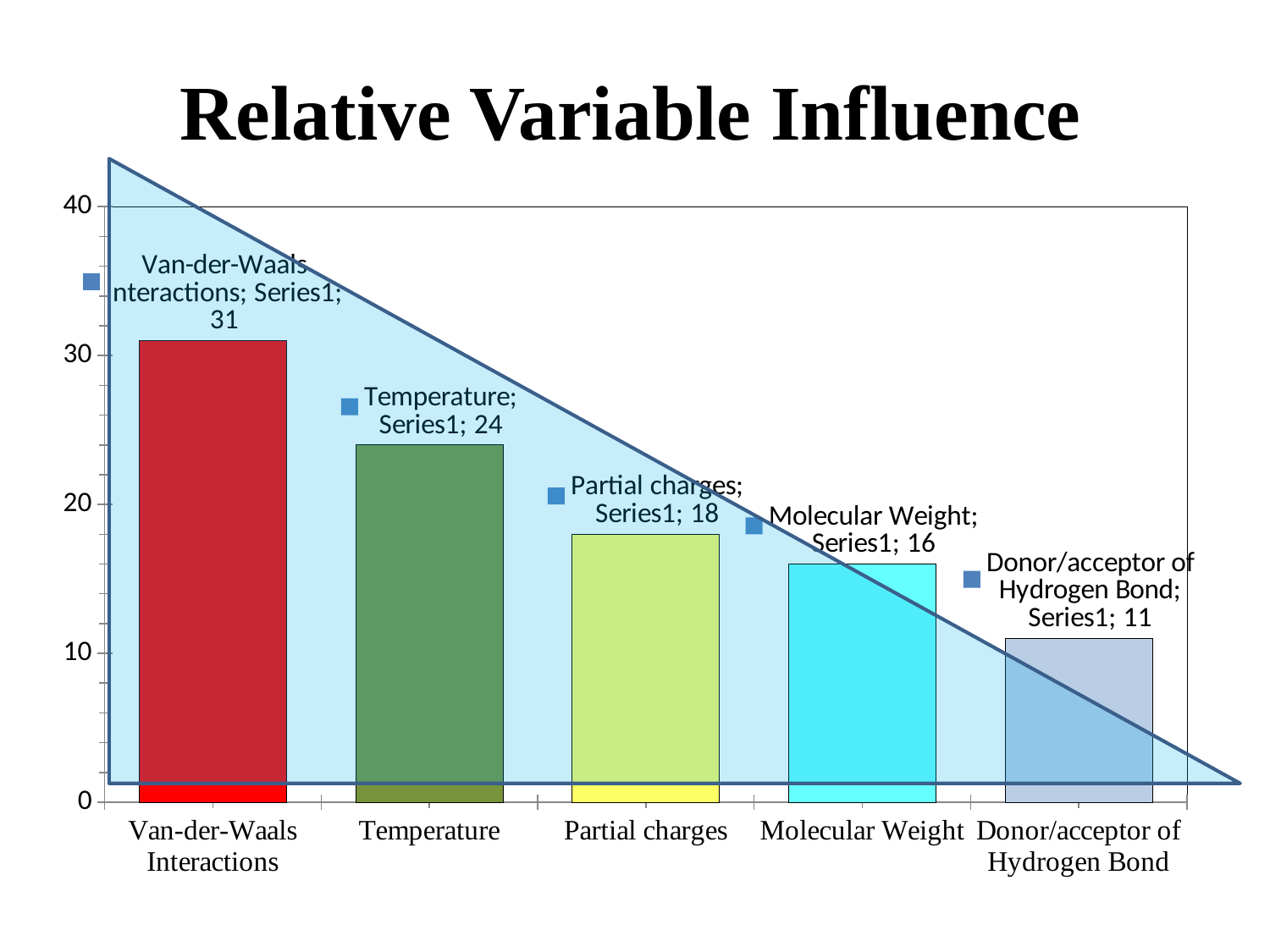
What is the value for Temperature? 24 Which category has the lowest value? Donor/acceptor of Hydrogen Bond What is the value for Donor/acceptor of Hydrogen Bond? 11 What kind of chart is shown on the slide? Bar chart What is the value for Partial charges? 18 Do the values rise or fall from left to right along the x axis? Fall What is the value for Van-der-Waals Interactions? 31 How many categories are shown on the x axis? 5 What is the difference between the values for Van-der-Waals Interactions and Temperature? 7 What is the difference between the values for Molecular Weight and Donor/acceptor of Hydrogen Bond? 5 Which is larger, the value for Partial charges or the value for Molecular Weight? Partial charges Which category has the highest value? Van-der-Waals Interactions